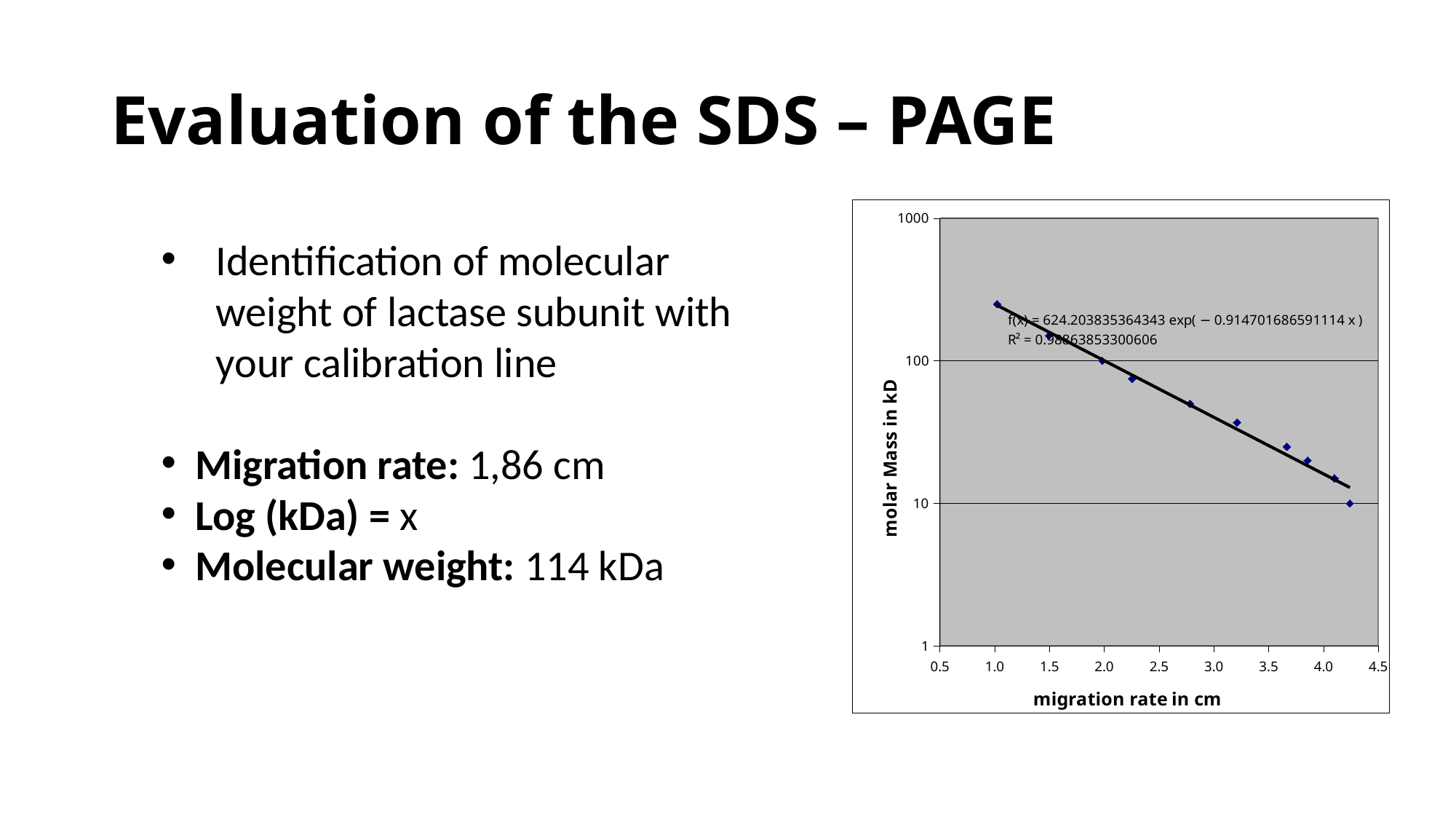
What is the label of the y axis of the chart? molar Mass in kD Is the molar mass of the data point at a migration rate of about 2.8 cm greater or less than 10? greater How many data points are plotted on the chart? 10 What is the highest tick value shown on the y axis of the chart? 1000 Is the molar mass of the data point at a migration rate of about 3.2 cm greater or less than 100? less Is the molar mass of the data point at a migration rate of about 2.8 cm greater or less than 100? less Do the plotted molar mass values rise or fall as the migration rate increases? fall What is the label of the x axis of the chart? migration rate in cm Which data point has the higher molar mass: the one at a migration rate of about 1.0 cm or the one at about 4.1 cm? the one at about 1.0 cm What kind of chart is shown on the slide? scatter chart